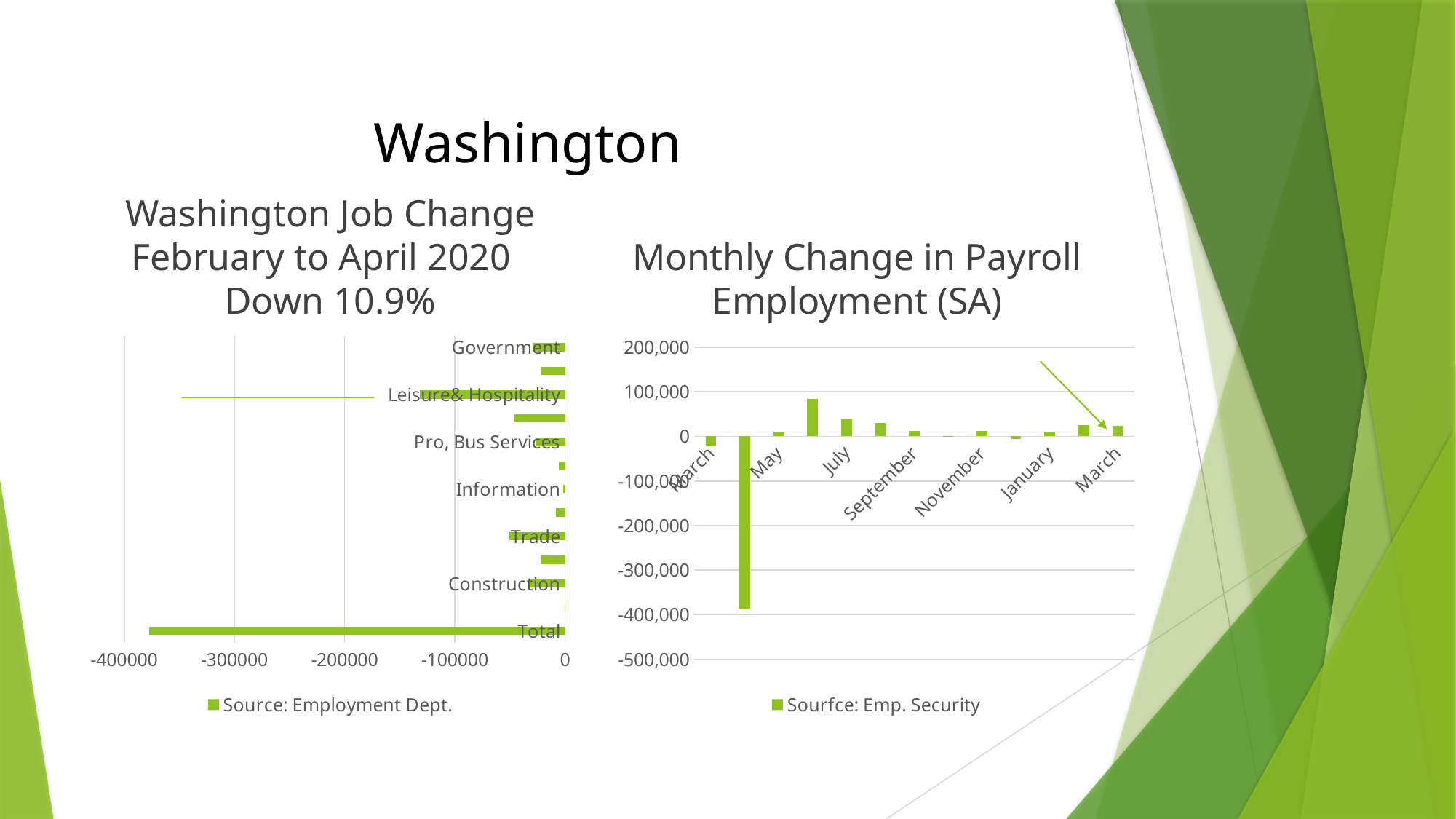
In the right chart 'Monthly Change in Payroll Employment (SA)', is the lowest value on the chart greater or less than -300,000? less In the left chart 'Washington Job Change February to April 2020', which labeled category has the lowest (most negative) value? Total In the right chart 'Monthly Change in Payroll Employment (SA)', is the value for the first March greater or less than 0? less In the right chart 'Monthly Change in Payroll Employment (SA)', is the value for May greater or less than 100,000? less What kind of chart is the 'Washington Job Change February to April 2020 Down 10.9%' chart on the left? bar chart How many series does the legend of the right chart 'Monthly Change in Payroll Employment (SA)' list? 1 In the left chart 'Washington Job Change February to April 2020', which has the lower value, Total or Government? Total What is the legend entry of the right chart 'Monthly Change in Payroll Employment (SA)'? Sourfce: Emp. Security What is the legend entry of the left chart 'Washington Job Change February to April 2020'? Source: Employment Dept. What kind of chart is the 'Monthly Change in Payroll Employment (SA)' chart on the right? bar chart